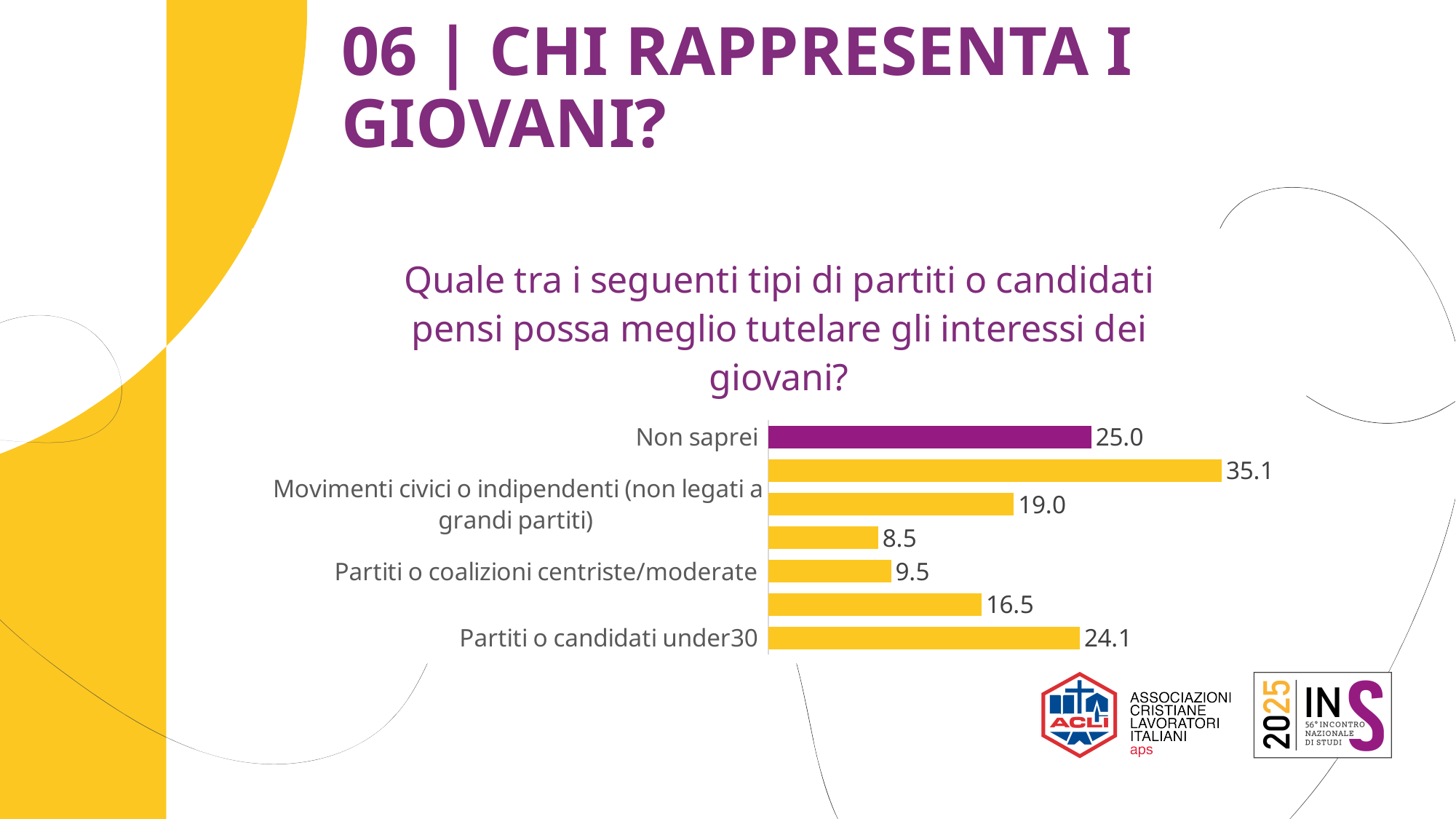
What is the lowest value shown on the chart? 8.5 What is the value for "Non saprei"? 25.0 What is the difference between the values for "Non saprei" and "Partiti o candidati under30"? 0.9 How many bars are plotted on the chart? 7 Which has a larger value, "Movimenti civici o indipendenti (non legati a grandi partiti)" or "Partiti o coalizioni centriste/moderate"? Movimenti civici o indipendenti (non legati a grandi partiti) What is the value for "Partiti o coalizioni centriste/moderate"? 9.5 Which has a larger value, "Non saprei" or "Partiti o candidati under30"? Non saprei What is the highest value shown on the chart? 35.1 What is the value for "Movimenti civici o indipendenti (non legati a grandi partiti)"? 19.0 What colour is the bar for "Non saprei"? Purple What kind of chart is shown on the slide? Bar chart What is the value for "Partiti o candidati under30"? 24.1